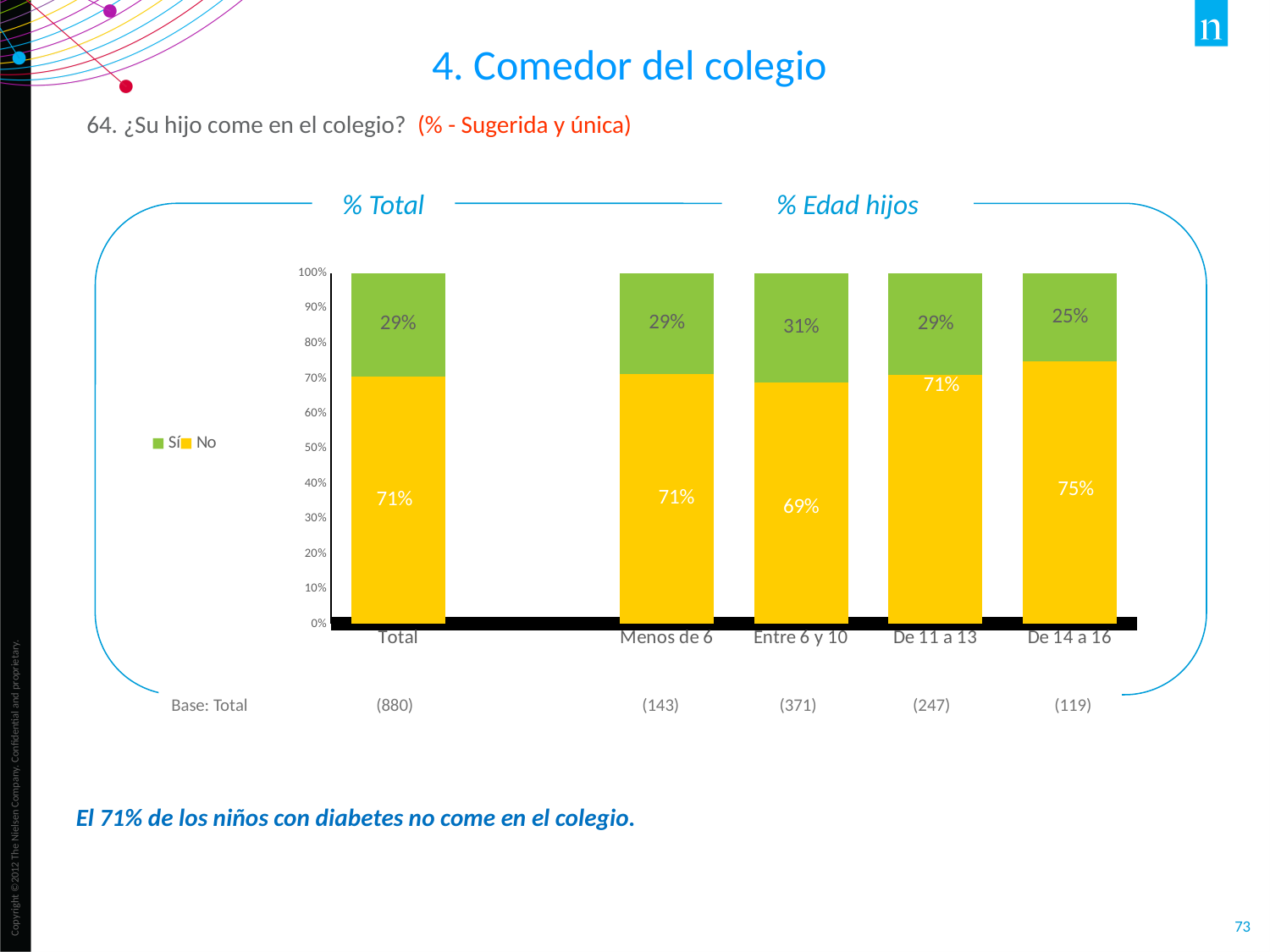
How many categories are shown on the x axis? 5 Which category has the highest 'No' value? De 14 a 16 What kind of chart is shown on the slide? Stacked bar chart Which is larger: the 'Sí' value for 'Entre 6 y 10' or for 'De 14 a 16'? Entre 6 y 10 What is the value of 'Sí' for the 'De 14 a 16' category? 25% How many series does the legend list? 2 What is the total of the stacked bar for 'Menos de 6'? 100% What is the difference between the 'No' values for 'De 14 a 16' and 'Entre 6 y 10'? 6% What is the value of 'Sí' for the 'Entre 6 y 10' category? 31% What is the value of 'No' for the Total category? 71% What is the value of 'No' for the 'De 14 a 16' category? 75% Which category has the lowest 'No' value? Entre 6 y 10